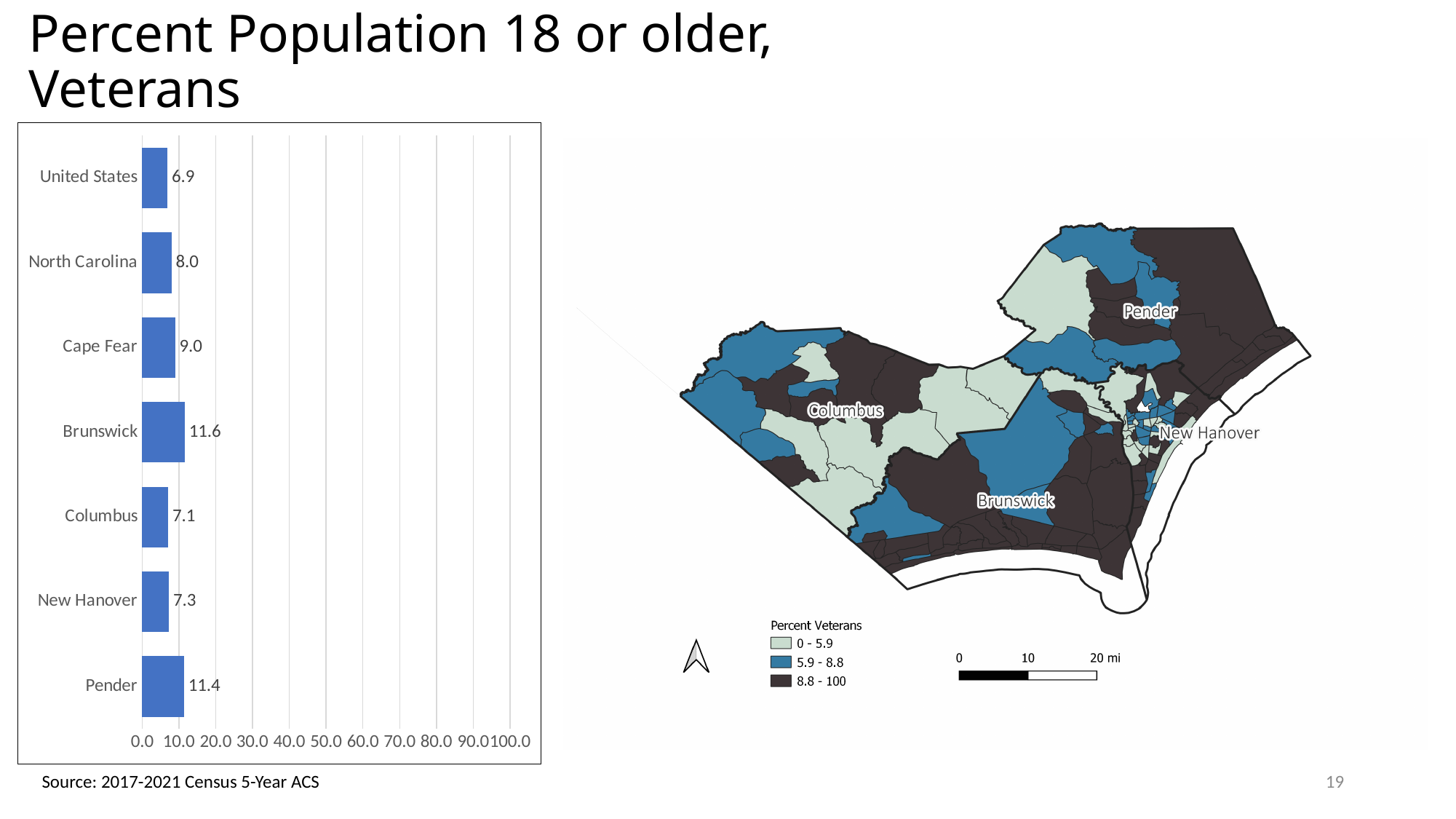
What is the value for the United States in the bar chart? 6.9 What is the value for Pender in the bar chart? 11.4 What is the difference between the values for Brunswick and Columbus in the bar chart? 4.5 Which is larger in the bar chart, the value for North Carolina or the value for New Hanover? North Carolina What kind of chart is shown on the left of the slide? bar chart What is the value for Brunswick in the bar chart? 11.6 What is the maximum value shown on the x axis of the bar chart? 100.0 How many categories are shown in the bar chart? 7 What is the value for Cape Fear in the bar chart? 9.0 Is the value for Pender in the bar chart greater or less than 10.0? greater Which category has the lowest value in the bar chart? United States Which category has the highest value in the bar chart? Brunswick